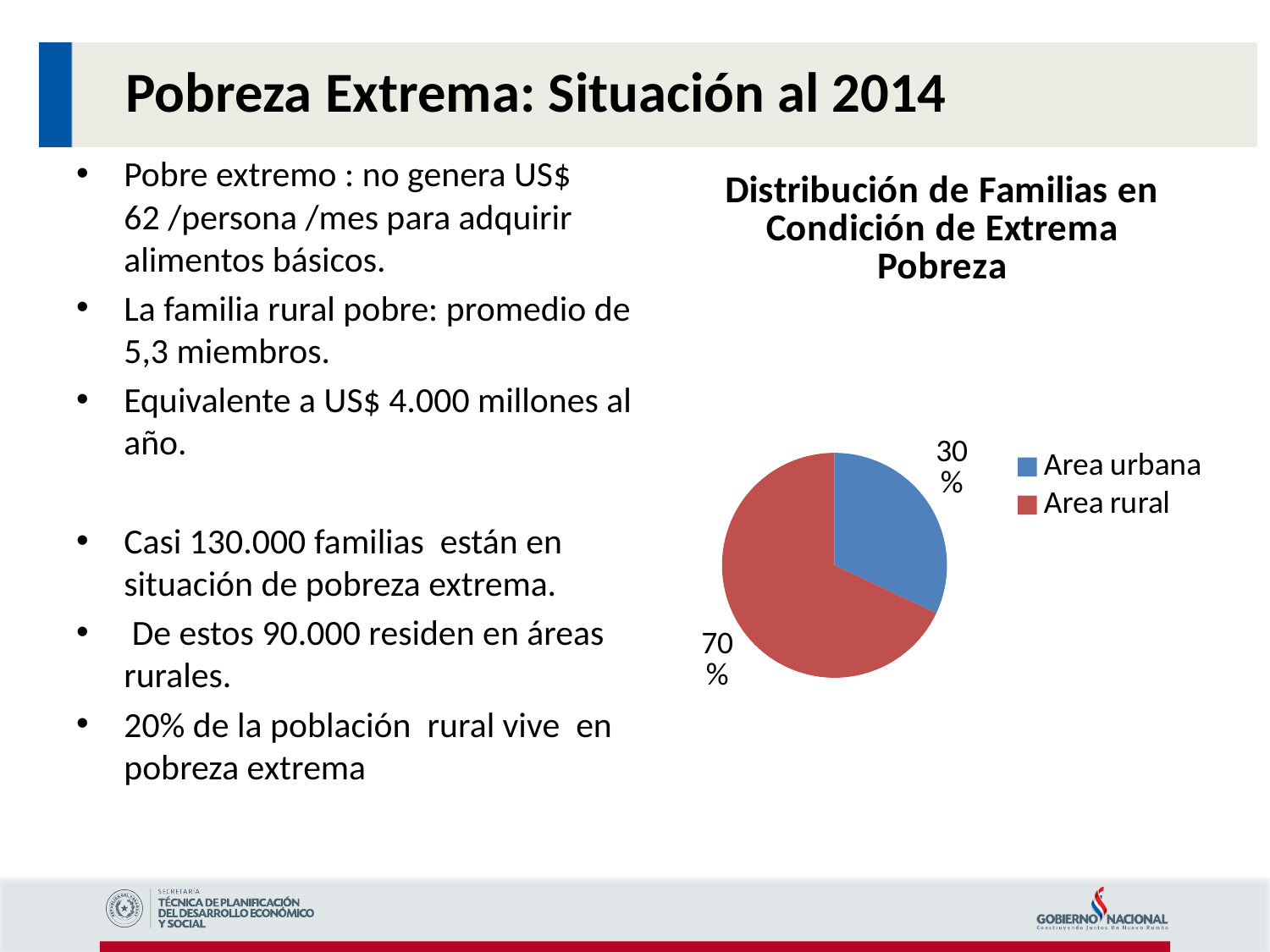
What colour is the Area urbana slice? blue What kind of chart is shown on the slide? pie chart What is the title of the chart? Distribución de Familias en Condición de Extrema Pobreza What is the difference in percentage points between Area rural and Area urbana? 40% Which is larger, the share for Area urbana or the share for Area rural? Area rural Which category has the smallest slice of the pie? Area urbana Which category has the largest slice of the pie? Area rural How many entries does the legend list? 2 How many slices does the pie chart have? 2 What share of the pie does Area rural represent? 70% What share of the pie does Area urbana represent? 30%